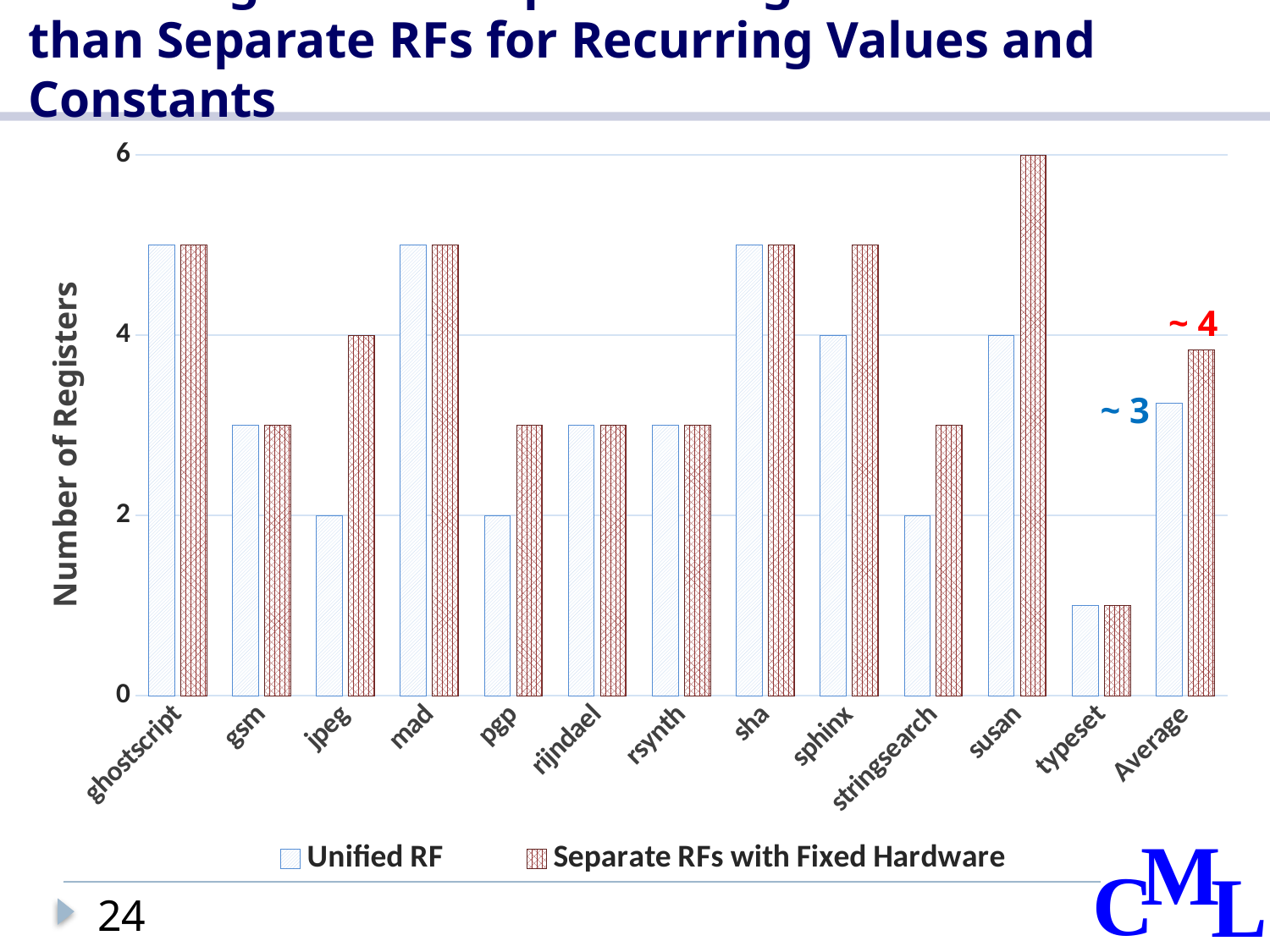
How many series does the legend list? 2 How many categories are shown along the x axis? 13 For susan, what is the difference between the Separate RFs with Fixed Hardware value and the Unified RF value? 2 What is the Unified RF value for sphinx? 4 Which category has the lowest Unified RF value? typeset Is the Unified RF value for ghostscript greater or less than 4? greater Which category has the highest Separate RFs with Fixed Hardware value? susan What is the Separate RFs with Fixed Hardware value for susan? 6 What is the Unified RF value for jpeg? 2 For jpeg, which series has the larger value, Unified RF or Separate RFs with Fixed Hardware? Separate RFs with Fixed Hardware What kind of chart is shown on the slide? bar chart What is the title of the y axis? Number of Registers